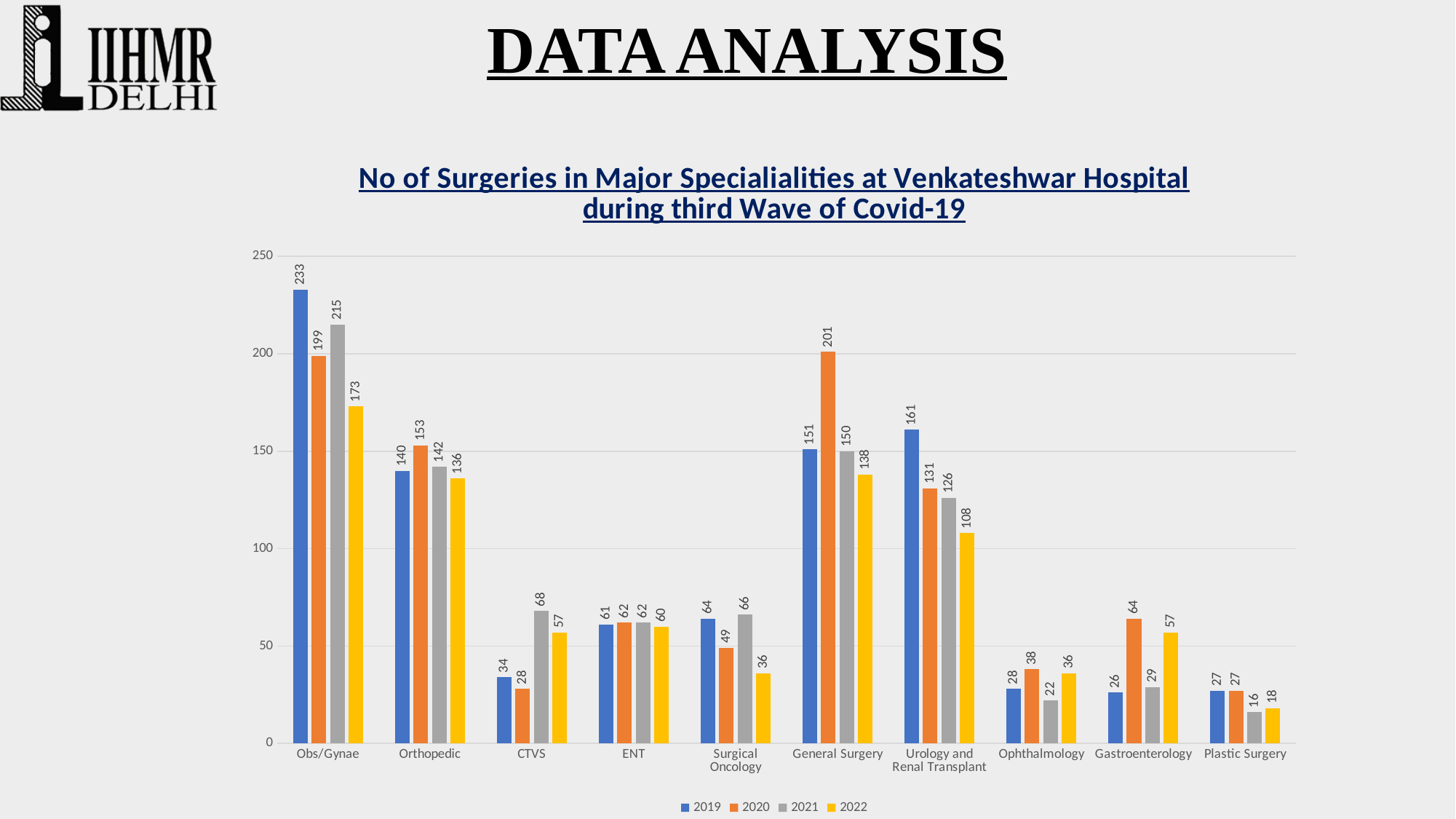
Which specialty has the highest number of surgeries in 2022? Obs/Gynae What is the number of surgeries for Obs/Gynae in 2019? 233 What is the difference between the 2019 and 2022 values for Urology and Renal Transplant? 53 Which colour represents the 2022 series in the legend? Yellow What is the number of surgeries for General Surgery in 2020? 201 How many specialties are shown on the x axis? 10 What kind of chart is shown on the slide? Bar chart Which is larger for Gastroenterology: the 2020 value or the 2022 value? 2020 What is the number of surgeries for Plastic Surgery in 2021? 16 Which specialty has the lowest number of surgeries in 2021? Plastic Surgery Is the value for Orthopedic in 2020 greater or less than 150? greater How many series does the legend list? 4